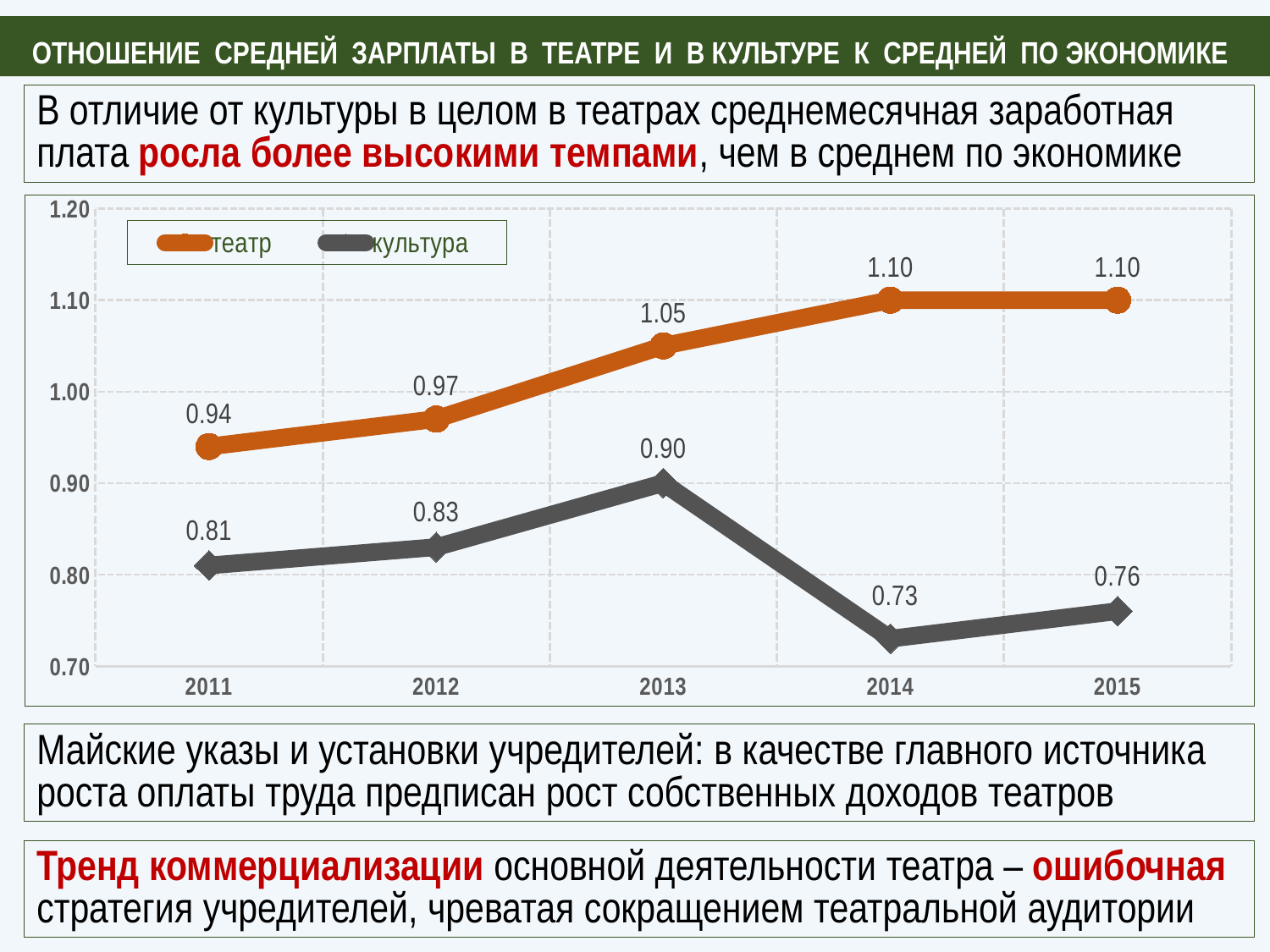
Does the театр series rise or fall from 2011 to 2014? rise Which series has the larger value in 2012, театр or культура? театр What is the value for театр in 2011? 0.94 How many series does the legend list? 2 In which year is the value for культура lowest? 2014 How many years are shown on the x axis? 5 Is the value for театр in 2014 greater or less than 1.00? greater What is the value for театр in 2013? 1.05 In which year is the value for культура highest? 2013 What is the difference between the театр and культура values in 2015? 0.34 What is the value for культура in 2014? 0.73 What kind of chart is shown on the slide? line chart